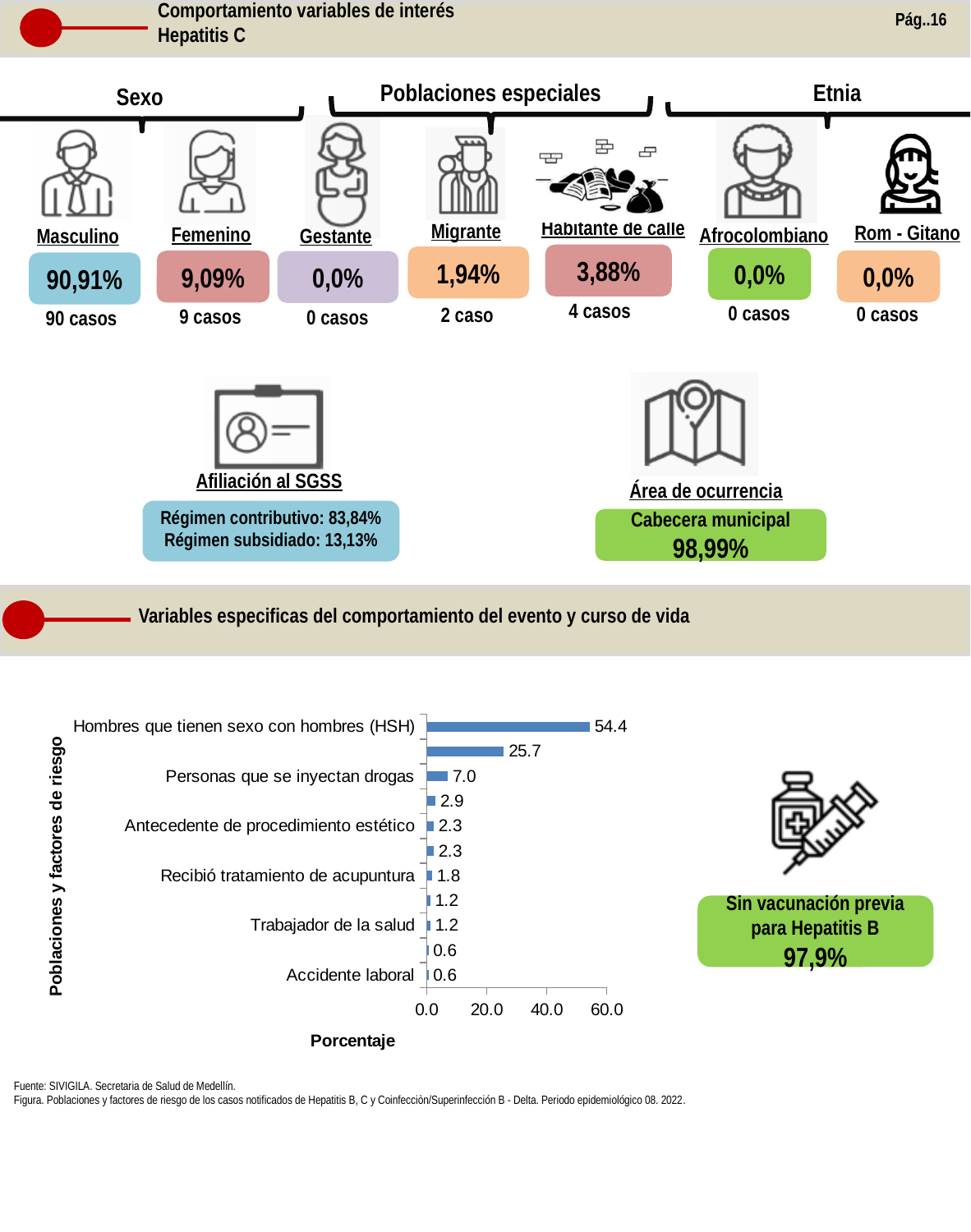
What type of chart is shown at the bottom of the slide? Bar chart Which category has the highest value in the bar chart? Hombres que tienen sexo con hombres (HSH) What is the difference between the values for Hombres que tienen sexo con hombres (HSH) and Personas que se inyectan drogas? 47.4 What is the title of the horizontal axis of the bar chart? Porcentaje What is the value for Hombres que tienen sexo con hombres (HSH)? 54.4 Is the value for Hombres que tienen sexo con hombres (HSH) greater or less than 40.0? greater What is the value for Trabajador de la salud? 1.2 What is the value for Recibió tratamiento de acupuntura? 1.8 What is the value for Antecedente de procedimiento estético? 2.3 Which is larger, the value for Trabajador de la salud or the value for Accidente laboral? Trabajador de la salud What is the value for Accidente laboral? 0.6 What is the value for Personas que se inyectan drogas? 7.0